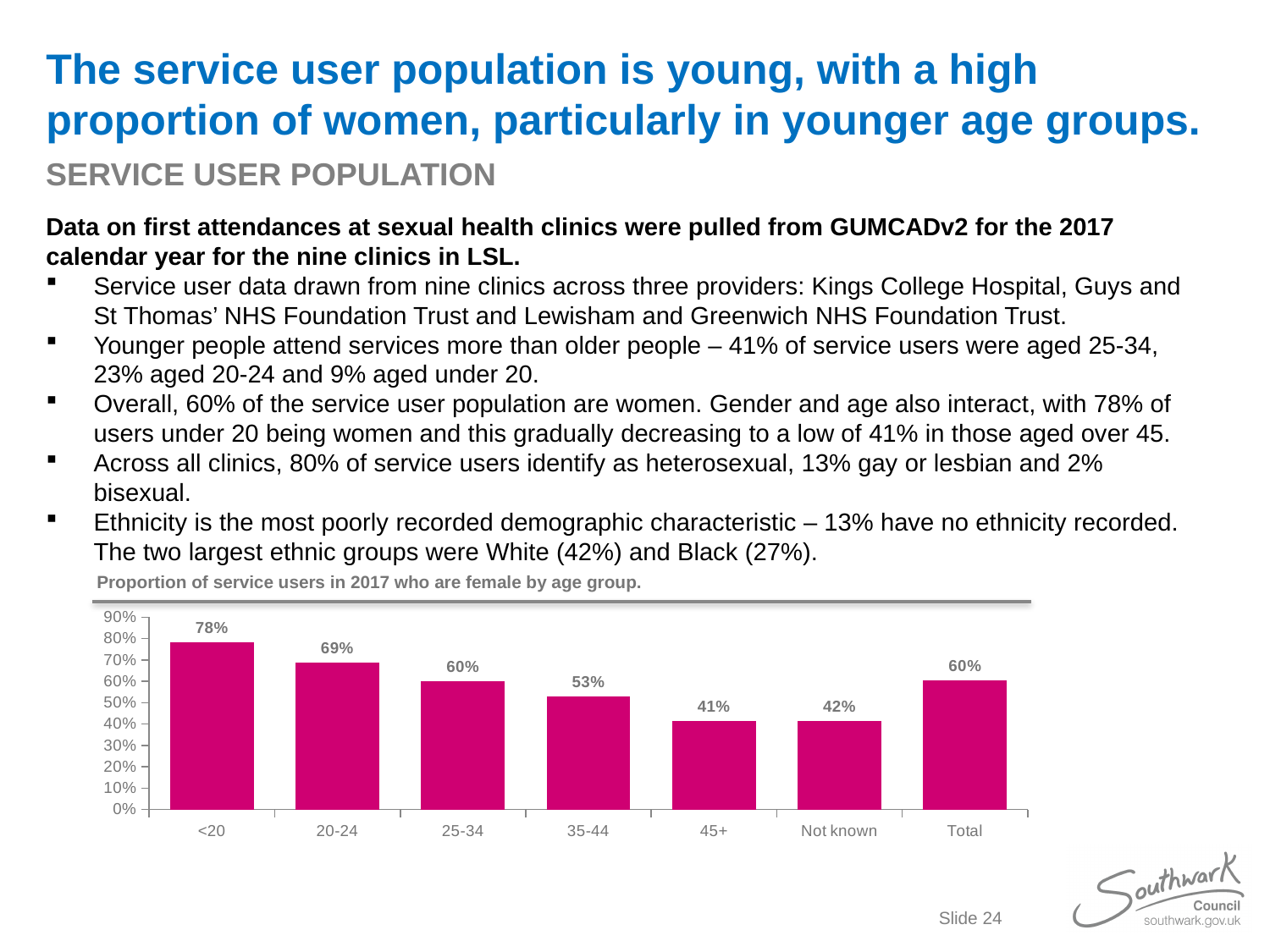
What proportion of service users aged under 20 are female? 78% What is the value shown for the 'Not known' category? 42% Is the value for the 25-34 age group greater or less than 50%? greater What is the difference between the values for the <20 and 45+ age groups? 37 percentage points Which is larger, the value for 20-24 or the value for 35-44? 20-24 What is the title of the chart? Proportion of service users in 2017 who are female by age group. How many categories are shown on the x axis of the chart? 7 Which category has the lowest value in the chart? 45+ Which age group has the highest proportion of female service users? <20 What is the value shown for the 35-44 age group? 53% What kind of chart is shown on the slide? Bar chart What is the difference between the values for 20-24 and 25-34? 9 percentage points